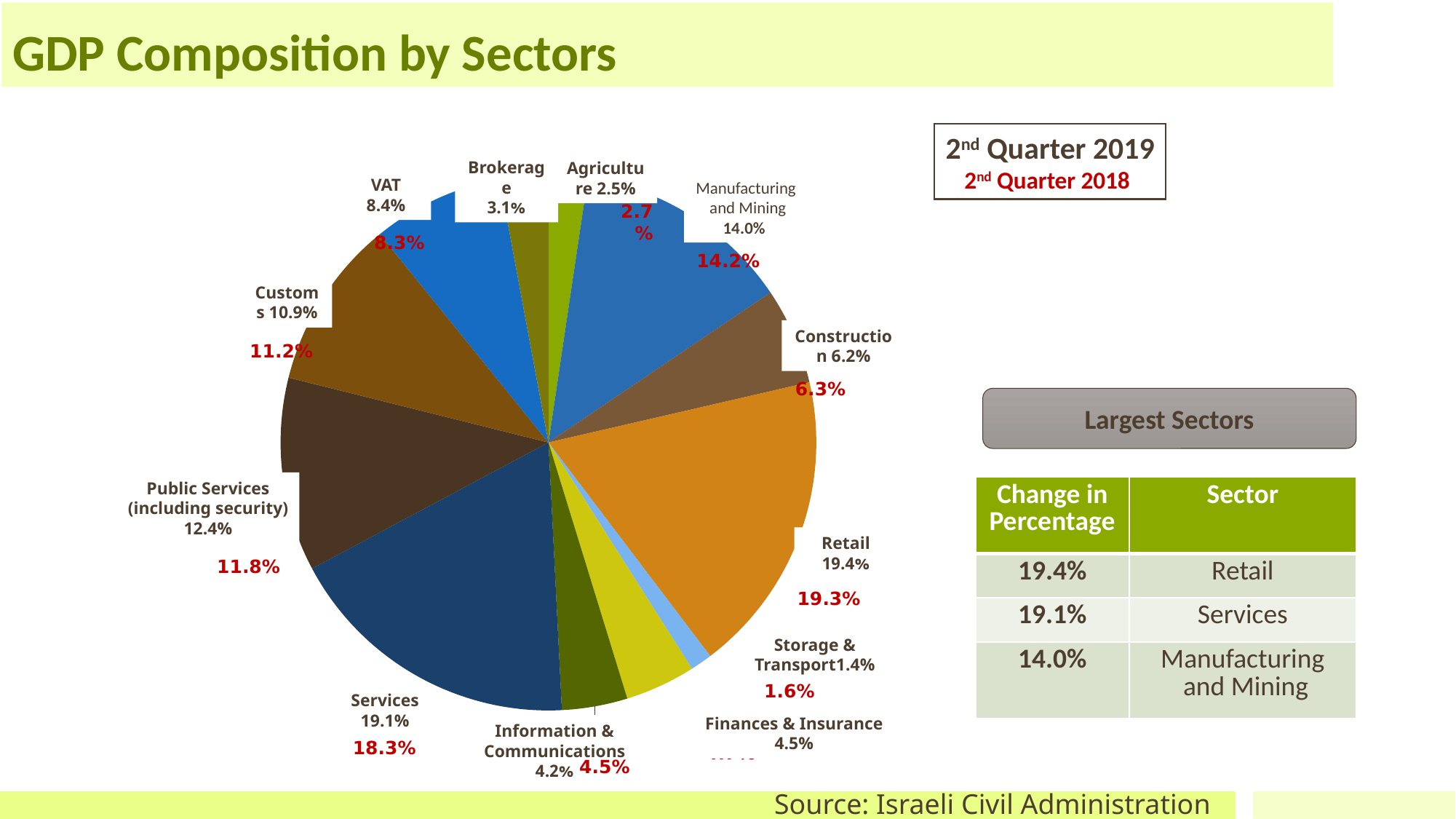
What is the title of the slide containing the pie chart? GDP Composition by Sectors What is the difference between the 2nd Quarter 2019 shares of Retail and Services? 0.3% How many sectors are shown in the pie chart? 12 What is the 2nd Quarter 2019 share of GDP for Retail? 19.4% Which sector has the largest share of GDP in the 2nd Quarter 2019? Retail What is the difference between the 2nd Quarter 2019 and 2nd Quarter 2018 shares for Services? 0.8% What is the 2nd Quarter 2019 share of GDP for Manufacturing and Mining? 14.0% What is the 2nd Quarter 2018 share of GDP for Services (shown in red)? 18.3% Which sector has a larger 2nd Quarter 2019 share, Customs or VAT? Customs Which sector has the smallest share of GDP in the 2nd Quarter 2019? Storage & Transport What is the 2nd Quarter 2019 share of GDP for Public Services (including security)? 12.4% What type of chart is shown on the slide? pie chart